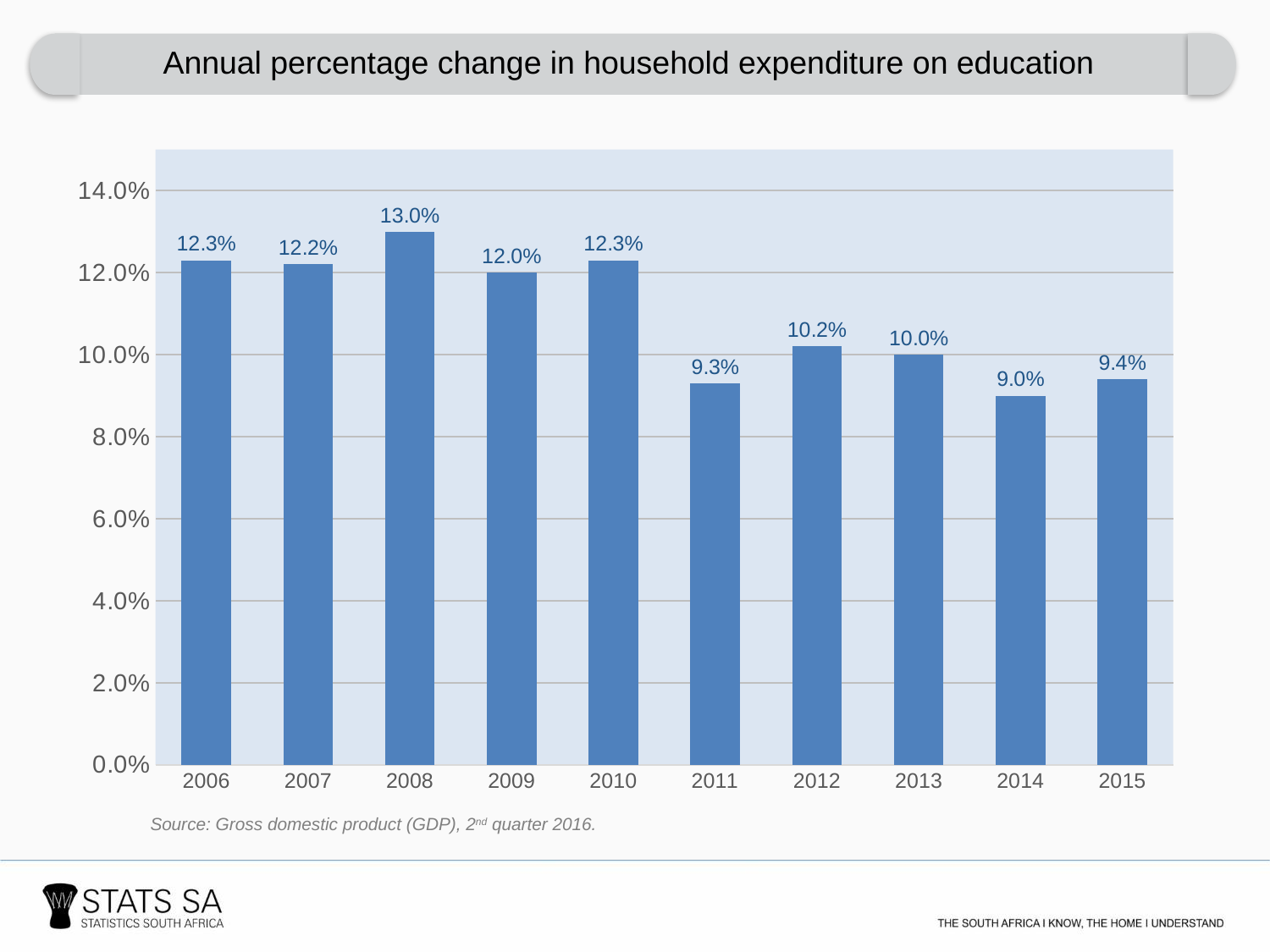
What is the difference between the values for 2008 and 2014? 4.0 percentage points What is the difference between the values for 2010 and 2011? 3.0 percentage points What is the annual percentage change in household expenditure on education for 2008? 13.0% How many years are shown on the x axis? 10 Which year has the lowest annual percentage change? 2014 What kind of chart is shown on the slide? Bar chart Which year has the larger value, 2012 or 2015? 2012 What is the title of the chart? Annual percentage change in household expenditure on education Which year has the highest annual percentage change? 2008 Is the value for 2013 greater or less than 12.0%? less What is the value shown for 2011? 9.3% What is the value shown for 2014? 9.0%